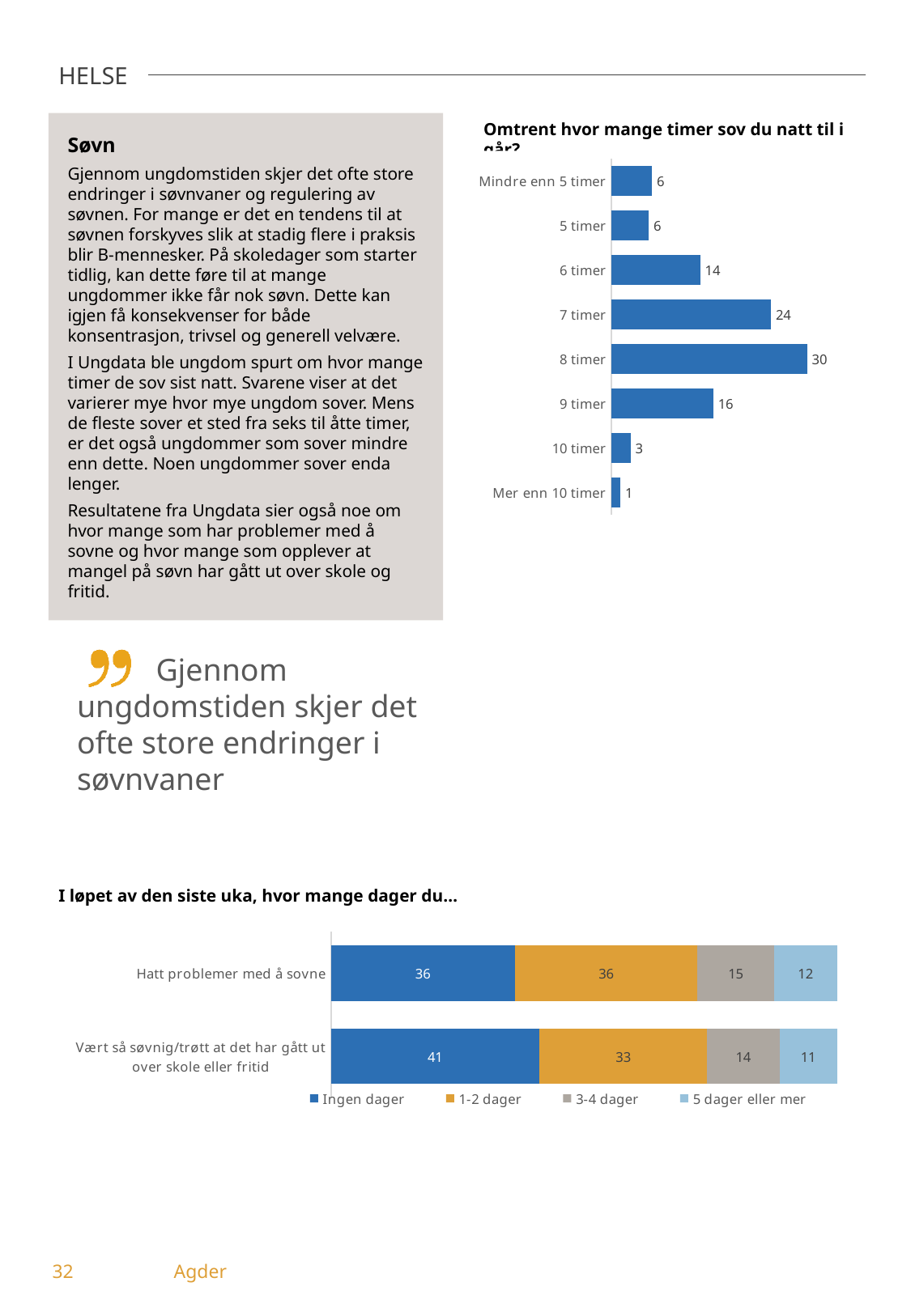
In the top-right bar chart about hours slept last night, what is the difference between the values for '7 timer' and '6 timer'? 10 In the top-right bar chart about hours slept last night, which category has the lowest value? Mer enn 10 timer In the bottom chart 'I løpet av den siste uka, hvor mange dager du…', what is the value for 'Ingen dager' in the 'Hatt problemer med å sovne' bar? 36 How many series does the legend list in the bottom chart 'I løpet av den siste uka, hvor mange dager du…'? 4 What kind of chart is the top-right chart about hours slept last night? Bar chart In the top-right bar chart about hours slept last night, which is larger: the value for '9 timer' or the value for '6 timer'? 9 timer In the top-right bar chart about hours slept last night, which category has the highest value? 8 timer In the bottom chart 'I løpet av den siste uka, hvor mange dager du…', which legend entry is shown in orange? 1-2 dager In the bottom chart 'I løpet av den siste uka, hvor mange dager du…', what is the total of the 'Hatt problemer med å sovne' bar? 99 How many categories are shown in the top-right bar chart about hours slept last night? 8 In the top-right bar chart about hours slept last night, what is the value for '8 timer'? 30 In the bottom chart 'I løpet av den siste uka, hvor mange dager du…', what is the value for '1-2 dager' in the 'Vært så søvnig/trøtt at det har gått ut over skole eller fritid' bar? 33